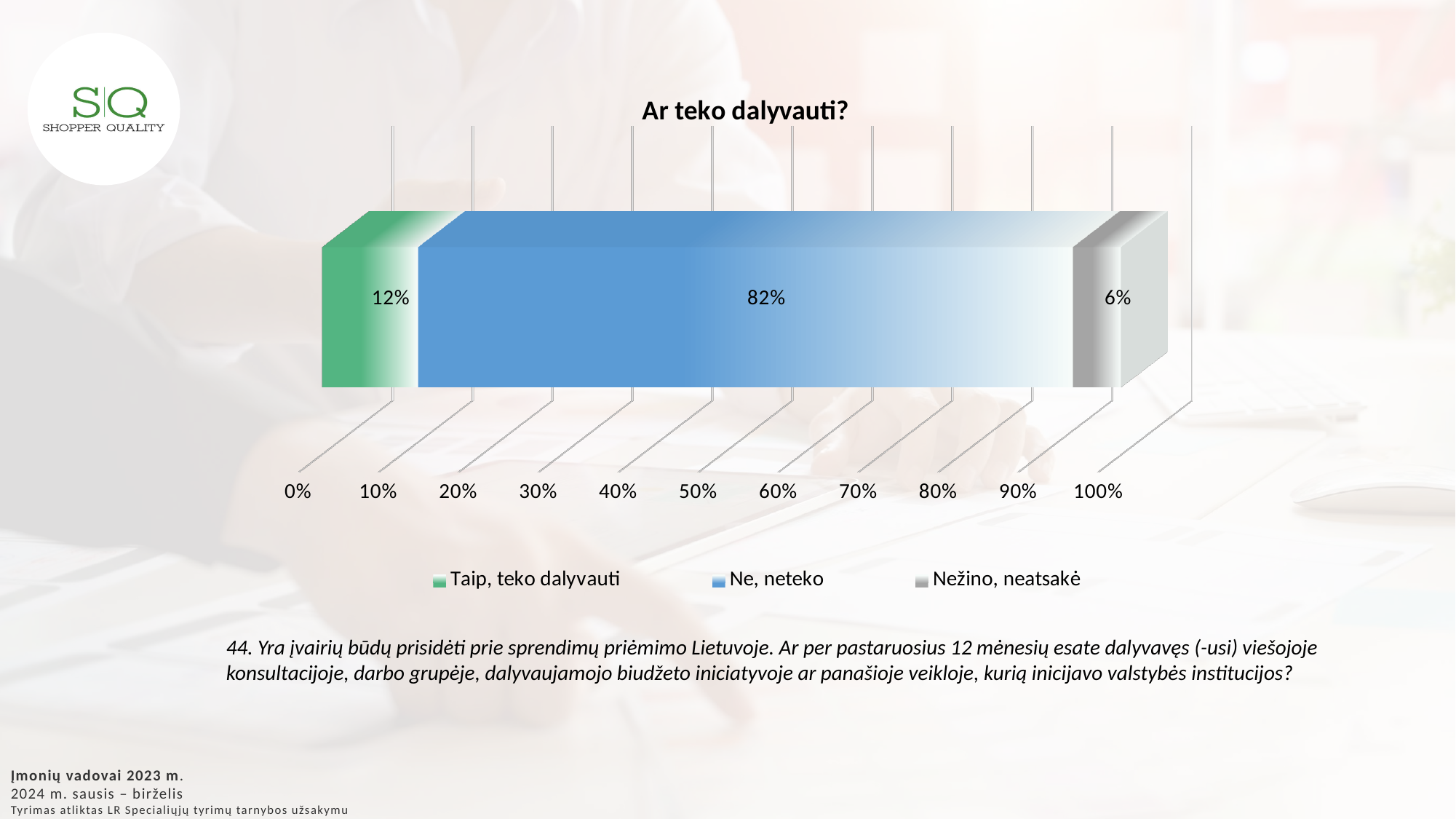
Is the value for "Ne, neteko" greater or less than 50%? greater What is the difference between the values for "Ne, neteko" and "Taip, teko dalyvauti"? 70% What is the total of the stacked bar? 100% Which series has the lowest value? Nežino, neatsakė What is the value for "Taip, teko dalyvauti"? 12% How many series does the legend list? 3 What is the value for "Ne, neteko"? 82% Which is larger, the value for "Taip, teko dalyvauti" or for "Nežino, neatsakė"? Taip, teko dalyvauti Which series has the highest value? Ne, neteko What kind of chart is shown? Stacked bar chart What is the value for "Nežino, neatsakė"? 6% What is the title of the chart? Ar teko dalyvauti?